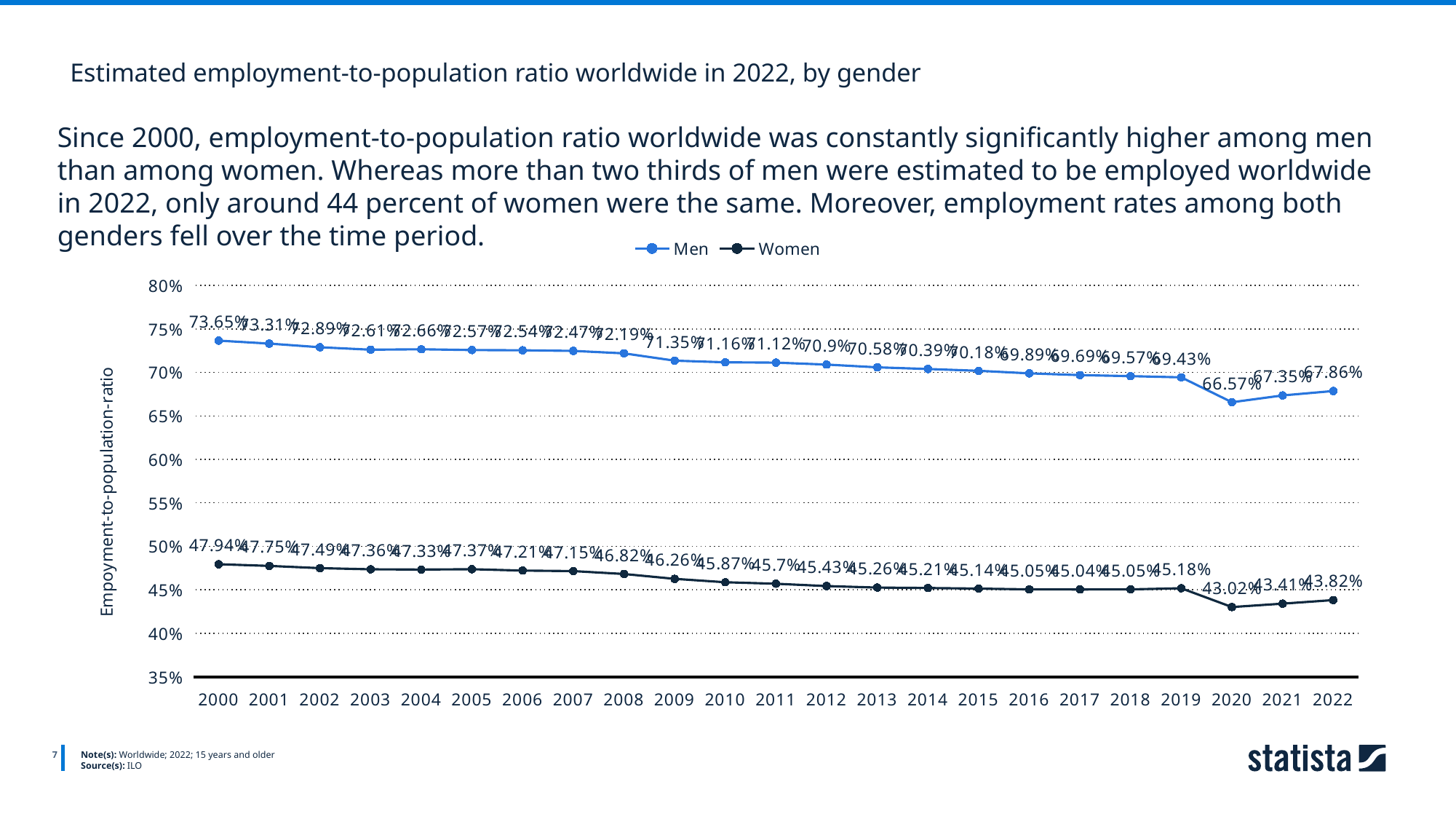
Is the value for Men in 2010 greater or less than 70%? greater What is the value for Men in 2022? 67.86% What is the value for Men in 2000? 73.65% How many years are shown on the x axis? 23 In which year is the Women series at its highest? 2000 What is the value for Women in 2020? 43.02% How many series does the legend list? 2 Does the Men series generally rise or fall from 2000 to 2022? fall What is the difference between the Men and Women values in 2022? 24.04 percentage points Which is larger for Men: the value in 2021 or the value in 2022? 2022 What kind of chart is shown on the slide? line chart In which year is the Men series at its lowest? 2020